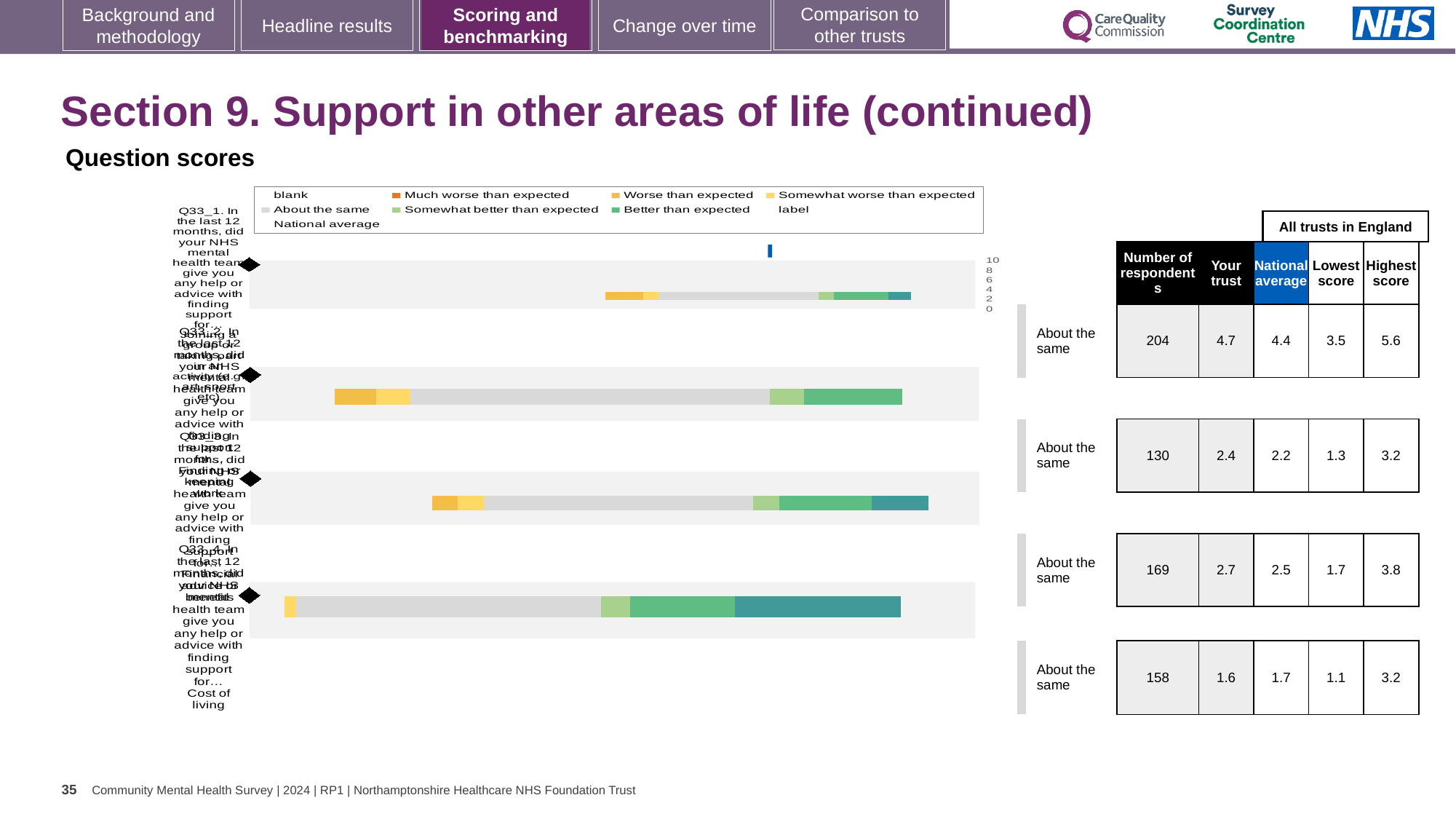
In the table beside the chart, which question has the lowest 'Your trust' score? Q33_4 (1.6) What colour does the legend use for 'About the same'? grey In the table beside the chart, which is larger for the first question (Q33_1): the 'Your trust' score or the national average? Your trust In the table beside the chart, what is the difference between the highest score and the lowest score for the first question (Q33_1)? 2.1 In the table beside the chart, what is the 'Your trust' score for the first question (Q33_1)? 4.7 How many stacked bars (questions) are plotted in the chart? 4 How many entries does the chart legend list? 9 In the table beside the chart, what is the number of respondents for the first question (Q33_1)? 204 In the table beside the chart, which question has the most respondents? Q33_1 (204) What is the last legend entry listed in the chart legend? National average What kind of chart is shown under 'Question scores'? bar chart In the table beside the chart, what is the national average for the fourth question (Q33_4, Cost of living)? 1.7